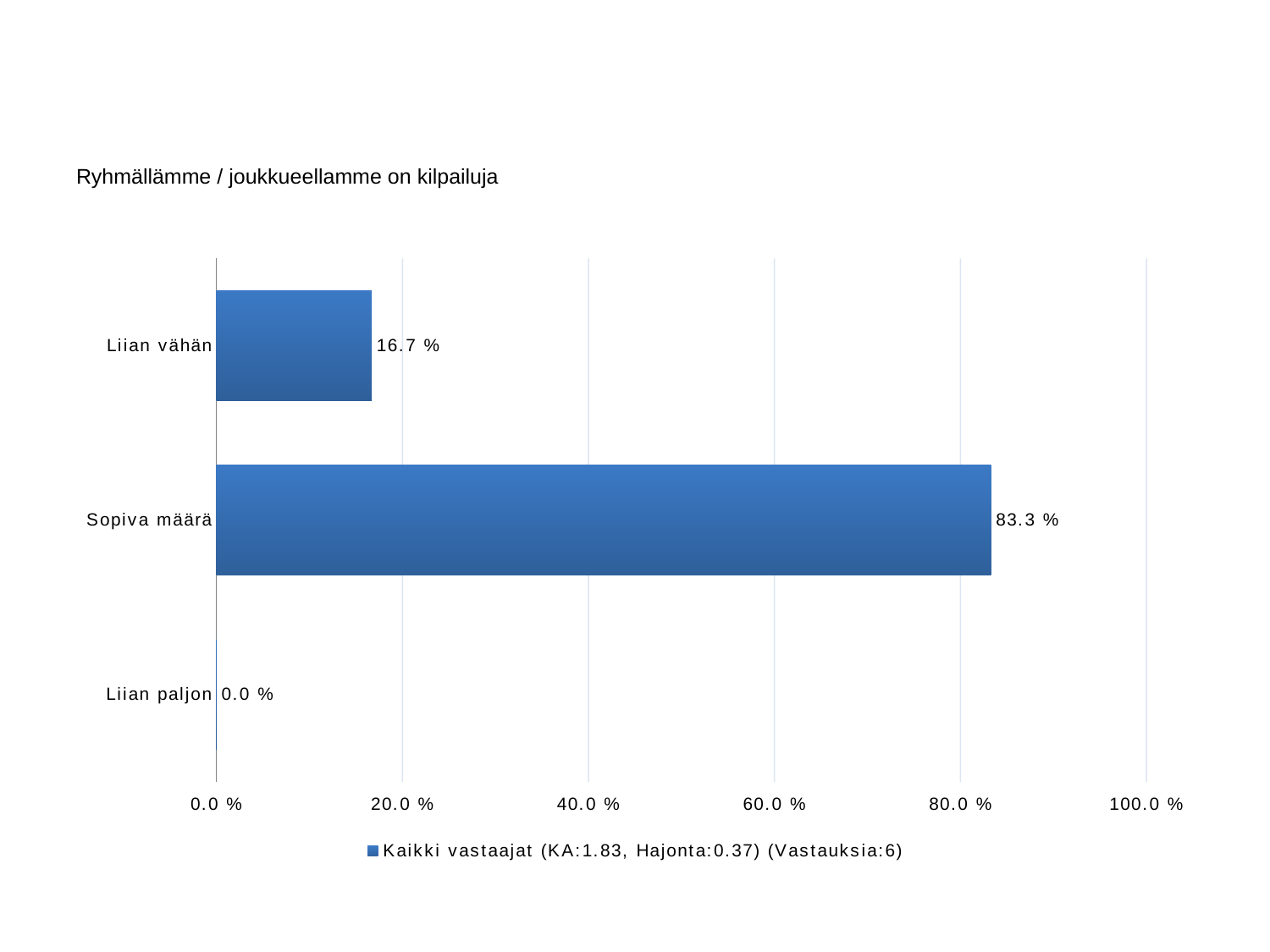
What is the title of the chart? Ryhmällämme / joukkueellamme on kilpailuja How many categories are shown on the chart? 3 What is the value for Liian paljon? 0.0 % What is the difference between the values for Sopiva määrä and Liian vähän? 66.6 % What is the value for Liian vähän? 16.7 % Which category has the highest value? Sopiva määrä What kind of chart is shown on the slide? bar chart What is the value for Sopiva määrä? 83.3 % Which is larger, the value for Liian vähän or the value for Sopiva määrä? Sopiva määrä How many series does the legend list? 1 Is the value for Sopiva määrä greater or less than 80.0 %? greater Which category has the lowest value? Liian paljon